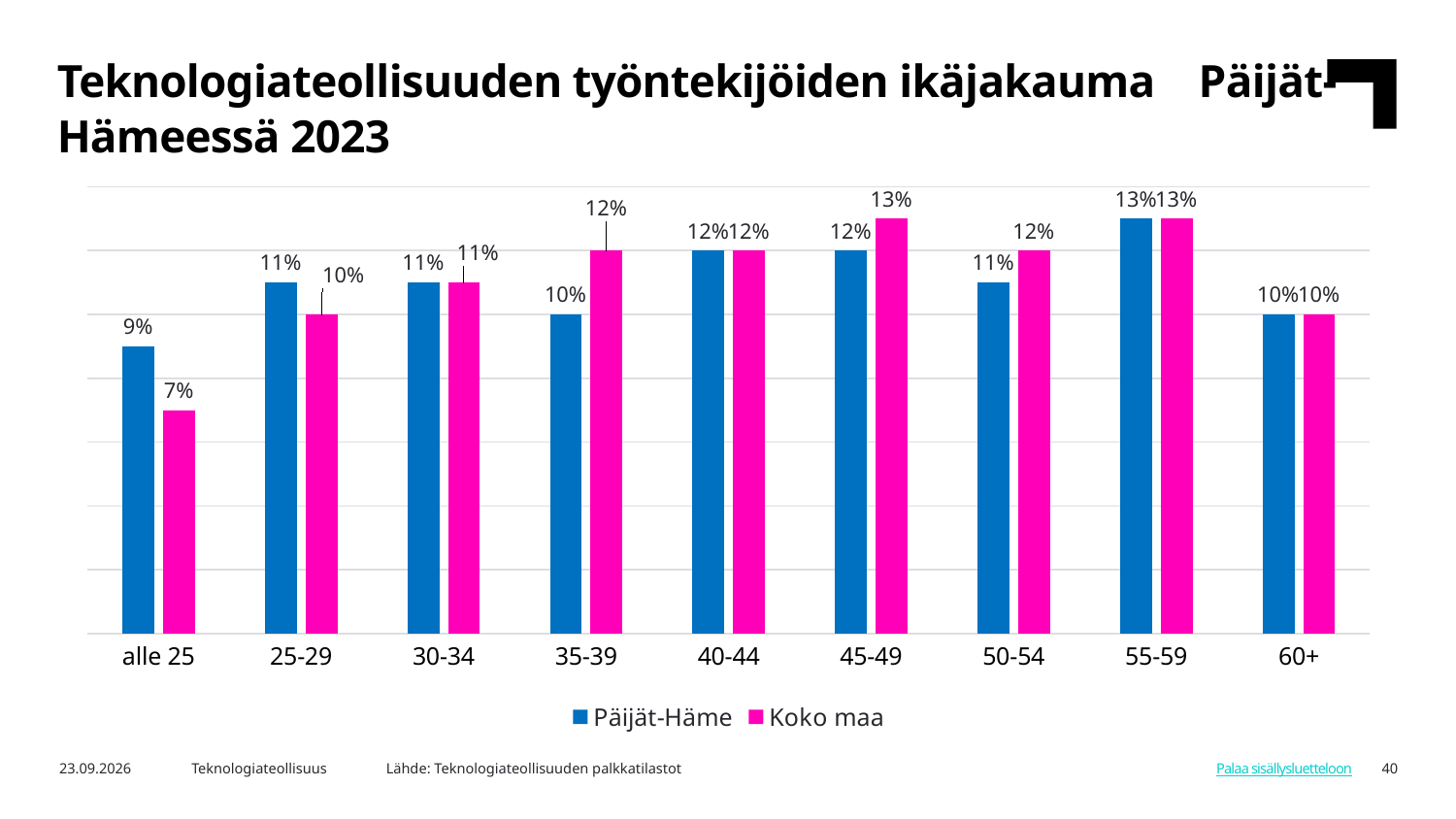
Which age category has the highest value for Päijät-Häme? 55-59 Which series is shown in pink in the legend? Koko maa What kind of chart is shown on the slide? bar chart How many series does the legend list? 2 What is the value for Koko maa in the 35-39 category? 12% What is the difference between the Päijät-Häme and Koko maa values in the 'alle 25' category? 2% What is the value for Koko maa in the 'alle 25' category? 7% Which age category has the lowest value for Päijät-Häme? alle 25 How many age categories are shown on the x axis? 9 In the 35-39 category, which is larger: Päijät-Häme or Koko maa? Koko maa Which age category has the lowest value for Koko maa? alle 25 What is the value for Päijät-Häme in the 'alle 25' category? 9%